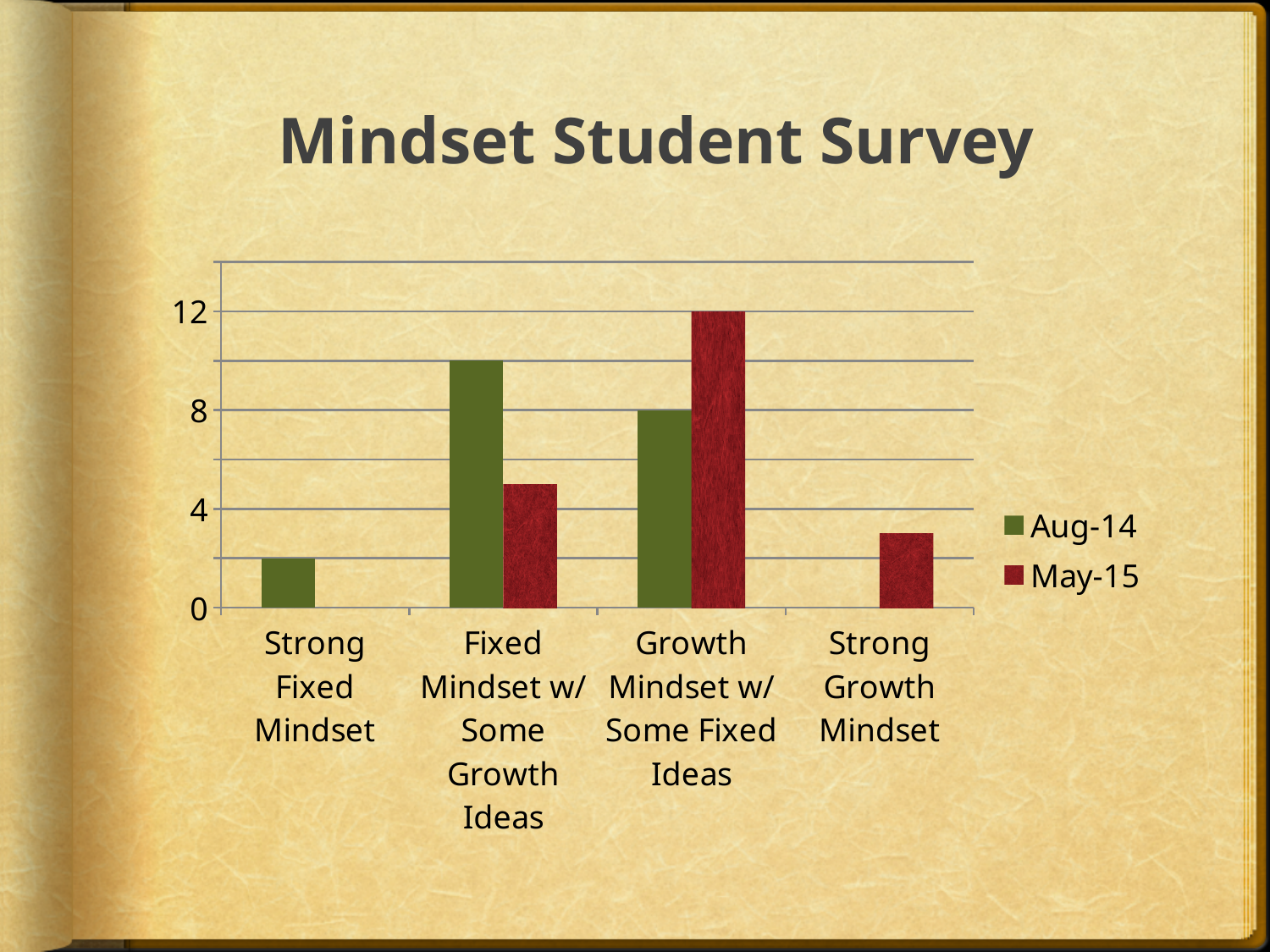
For Fixed Mindset w/ Some Growth Ideas, which is larger, the Aug-14 value or the May-15 value? Aug-14 What type of chart is shown on the slide? bar chart What is the difference between the May-15 and Aug-14 values for Growth Mindset w/ Some Fixed Ideas? 4 How many categories are shown on the x axis? 4 Which category has the highest May-15 value? Growth Mindset w/ Some Fixed Ideas Is the Aug-14 value for Fixed Mindset w/ Some Growth Ideas greater or less than 8? greater How many series does the legend list? 2 What is the title of the chart? Mindset Student Survey What is the Aug-14 value for Growth Mindset w/ Some Fixed Ideas? 8 Which category has the highest Aug-14 value? Fixed Mindset w/ Some Growth Ideas Is the May-15 value for Strong Growth Mindset greater or less than 4? less What is the May-15 value for Growth Mindset w/ Some Fixed Ideas? 12